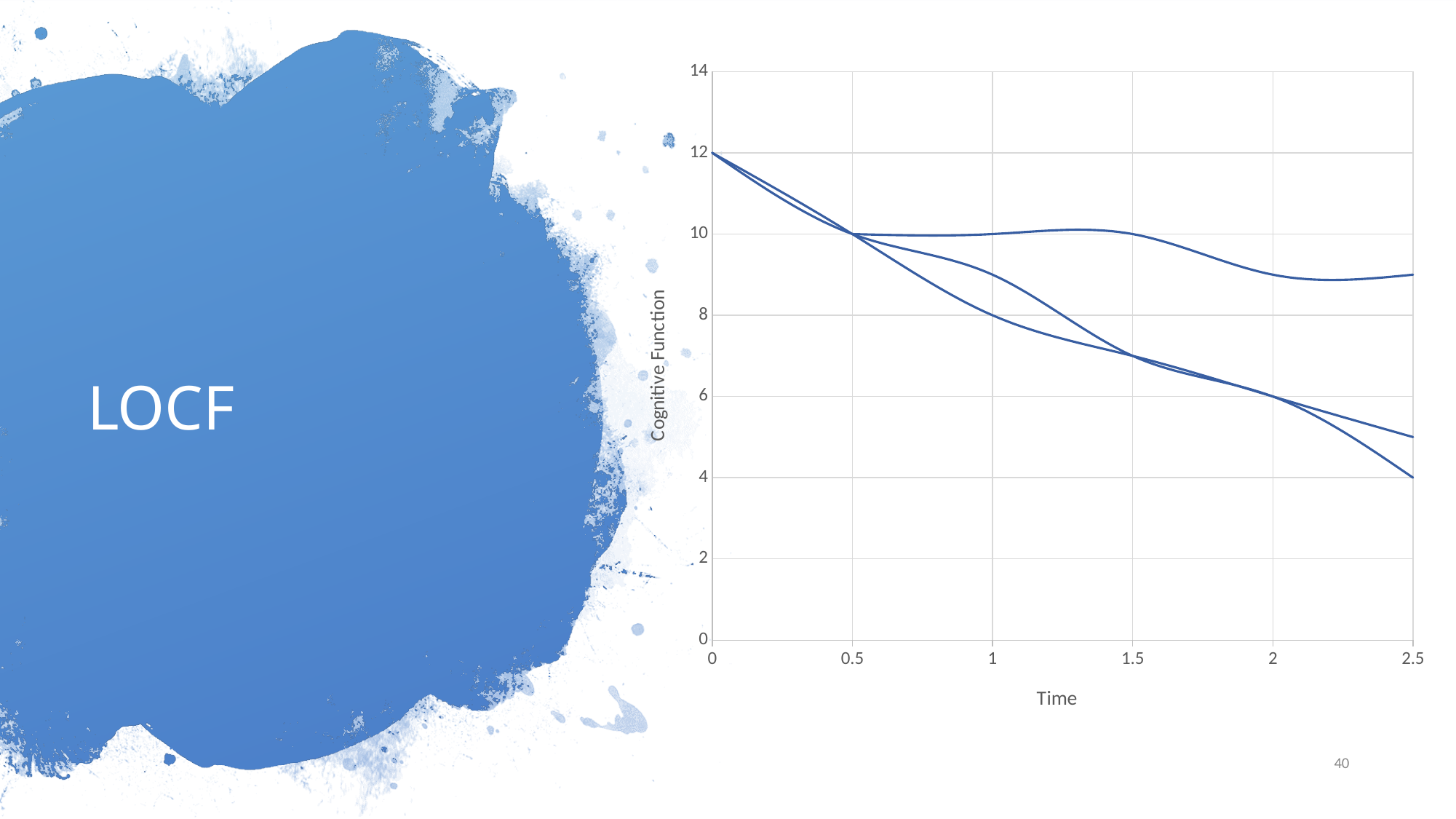
What value of Cognitive Function do all the lines share at Time 0? 12 Do the lines generally rise or fall as Time increases from 0 to 2.5? fall How many lines are plotted on the chart? 3 At Time 2.5, is the value of the lowest line greater or less than 6? less At Time 1.5, is the value of the highest line greater or less than 8? greater What value of Cognitive Function do all the lines share at Time 0.5? 10 At Time 2.5, is the value of the highest line greater or less than 8? greater How many tick labels are shown on the Time axis? 6 What is the title of the vertical axis of the chart? Cognitive Function What is the title of the horizontal axis of the chart? Time What kind of chart is shown on the slide? line chart What is the maximum value shown on the vertical axis of the chart? 14